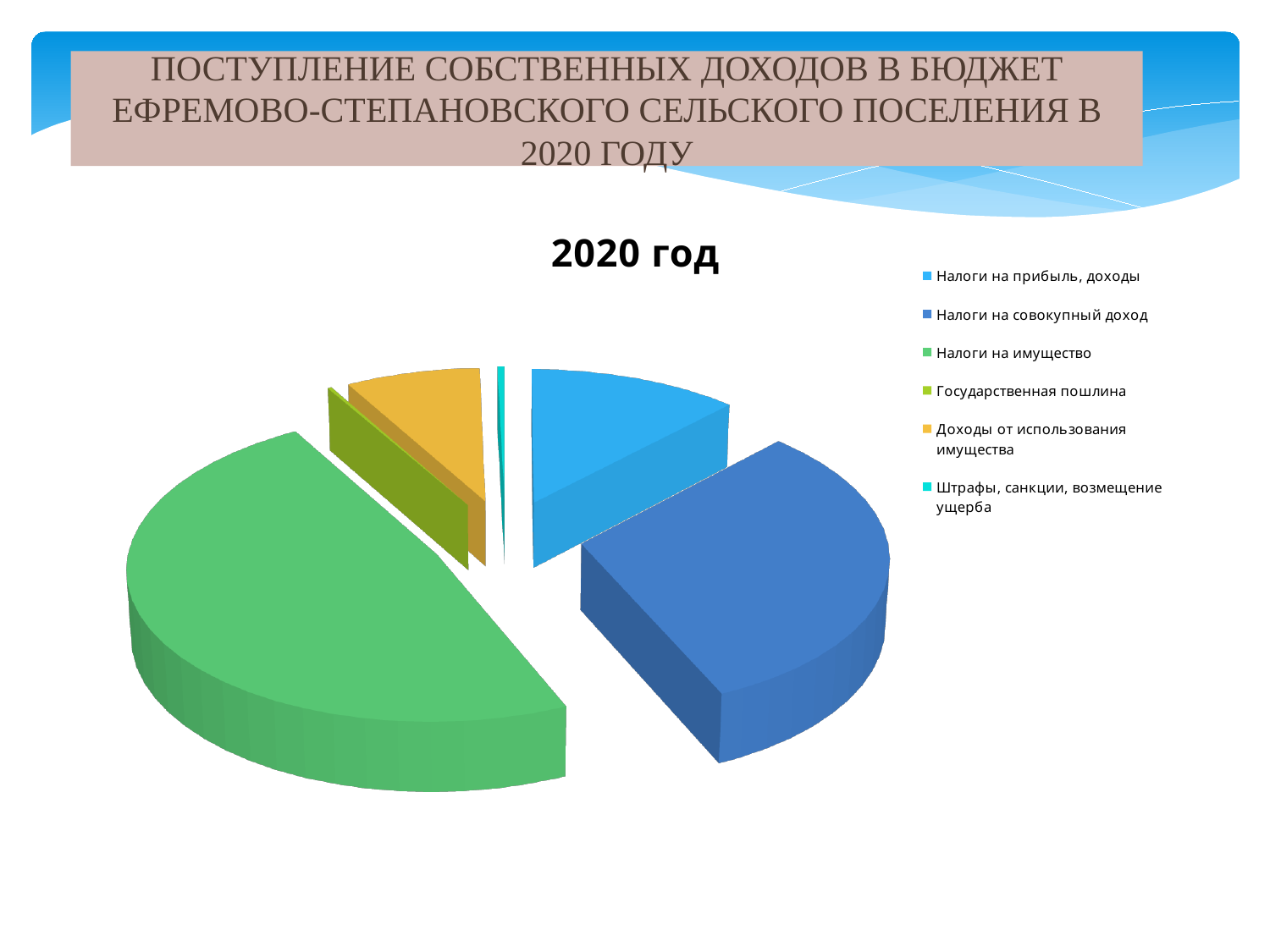
Which slice is larger: Налоги на совокупный доход or Налоги на прибыль, доходы? Налоги на совокупный доход How many categories does the legend of the pie chart list? 6 Which category has the largest slice of the pie? Налоги на имущество Which slice is larger: Государственная пошлина or Налоги на прибыль, доходы? Налоги на прибыль, доходы Which category has the smallest slice of the pie? Государственная пошлина What is the title of the chart? 2020 год Which slice is larger: Налоги на имущество or Налоги на совокупный доход? Налоги на имущество What kind of chart is shown on the slide? pie chart What colour is the slice for Налоги на имущество? green